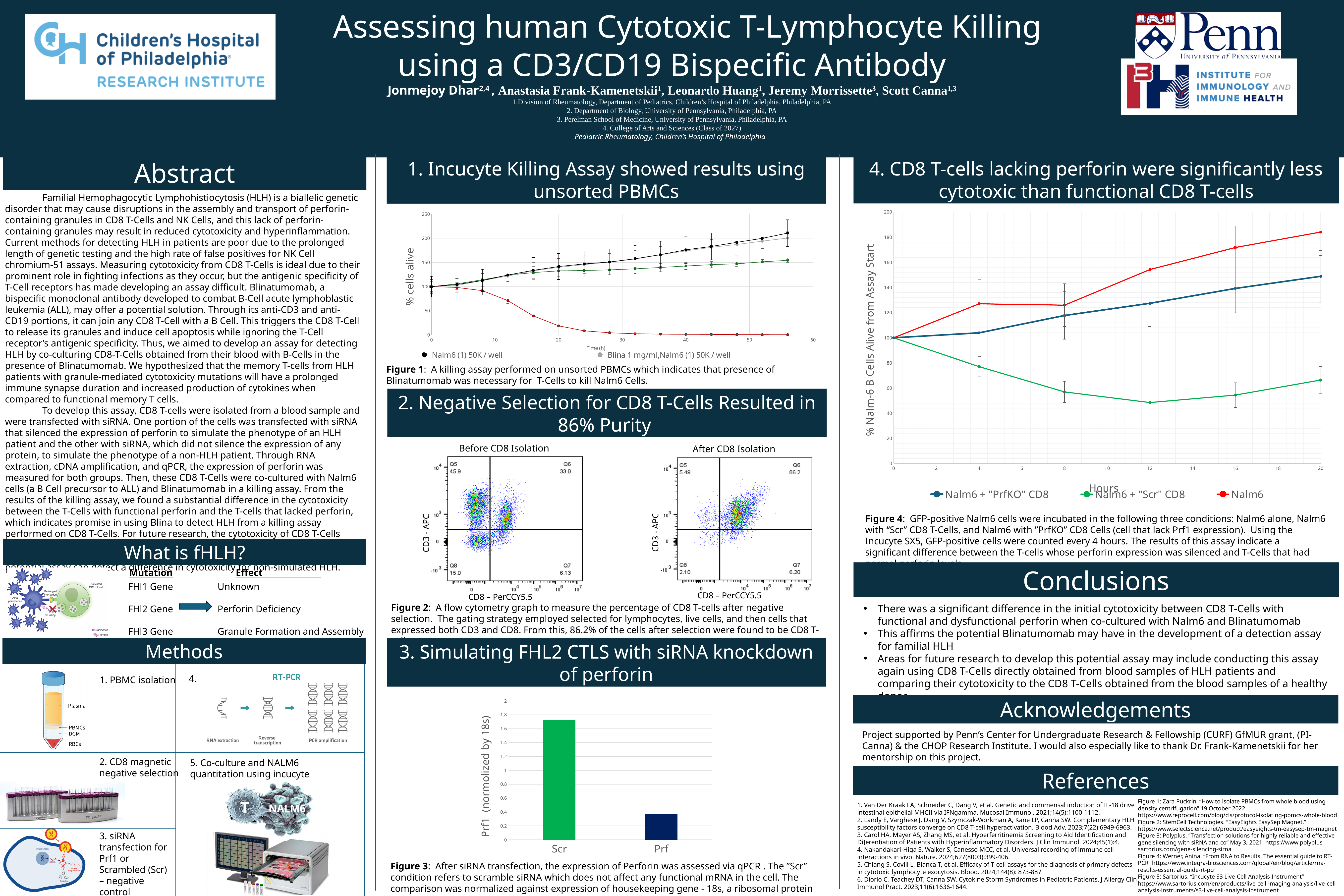
In the Figure 4 chart, what is the value of all three series at 0 hours? 100 In the Figure 4 chart, is the value for Nalm6 + "Scr" CD8 at 12 hours greater or less than 60? less What kind of chart is Figure 4 (% Nalm-6 B Cells Alive from Assay Start vs Hours)? line chart In the Figure 4 chart, at 8 hours, which is larger: Nalm6 + "PrfKO" CD8 or Nalm6 + "Scr" CD8? Nalm6 + "PrfKO" CD8 In the Figure 3 bar chart, which category has the higher Prf1 expression, Scr or Prf? Scr What kind of chart is Figure 3 (Prf1 normalized by 18s)? bar chart In the Figure 4 chart, is the value for Nalm6 at 20 hours greater or less than 160? greater In the Figure 4 chart, which series has the highest value at 20 hours? Nalm6 In the Figure 4 chart, which series has the lowest value at 20 hours? Nalm6 + "Scr" CD8 In the Figure 4 chart (CD8 T-cells lacking perforin), how many series does the legend list? 3 In the Figure 4 chart, does the Nalm6 series rise or fall from 0 to 20 hours? rise In the Figure 3 bar chart, is the value for Prf greater or less than 0.6? less